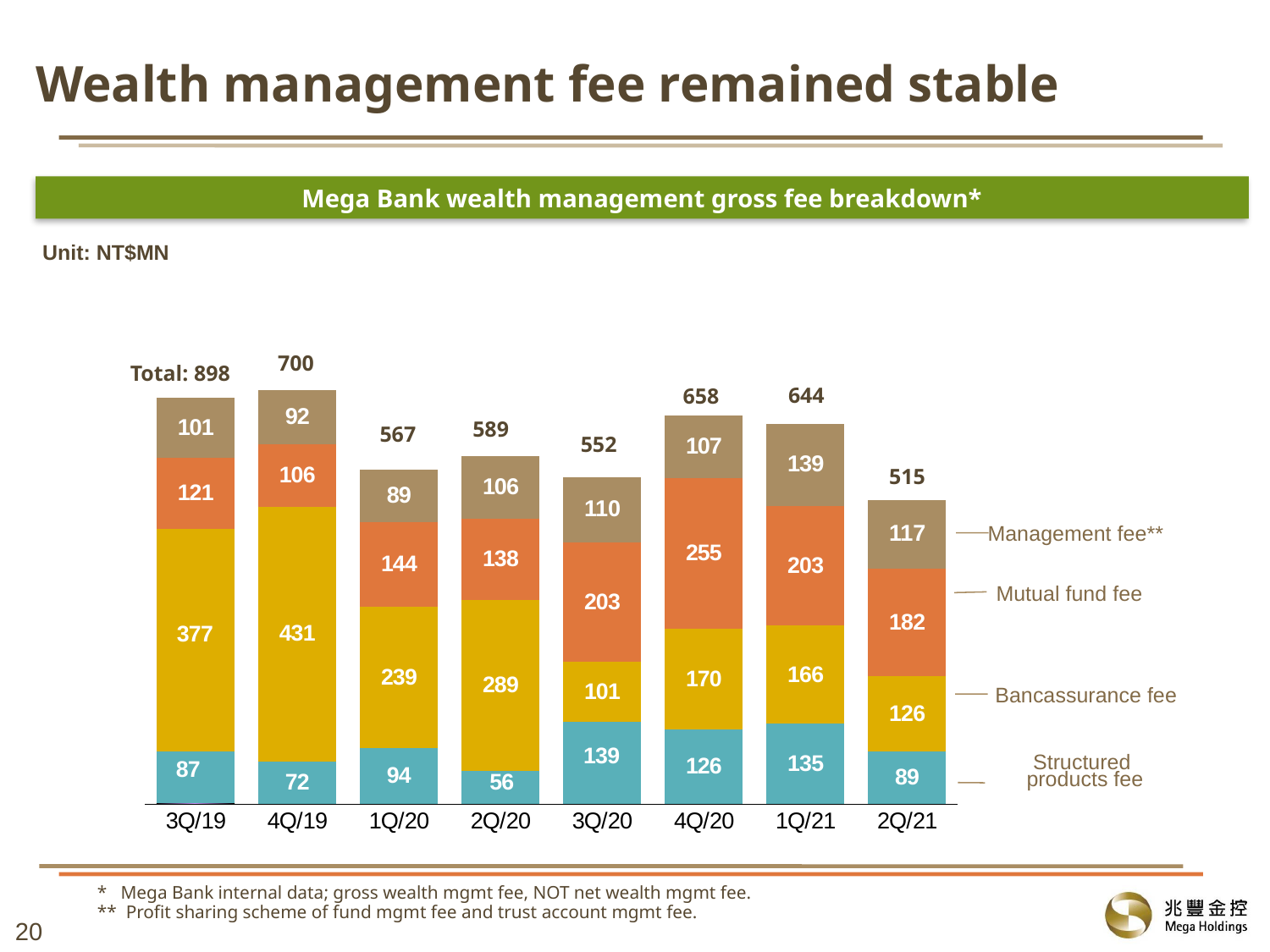
Which quarter has the highest total wealth management gross fee? 3Q/19 Which quarter has the lowest total wealth management gross fee? 2Q/21 What is the Mutual fund fee for 4Q/20? 255 How much higher is the Structured products fee in 3Q/20 than in 2Q/20? 83 What unit are the values in the chart expressed in? NT$MN What kind of chart is shown on the slide? Stacked bar chart What is the total wealth management gross fee for 2Q/21? 515 How many quarters are shown on the x axis of the chart? 8 Which quarter has the larger Management fee, 4Q/20 or 1Q/21? 1Q/21 What is the Bancassurance fee for 4Q/19? 431 How many fee categories (series) does the chart break the total into? 4 What is the Structured products fee for 1Q/21? 135